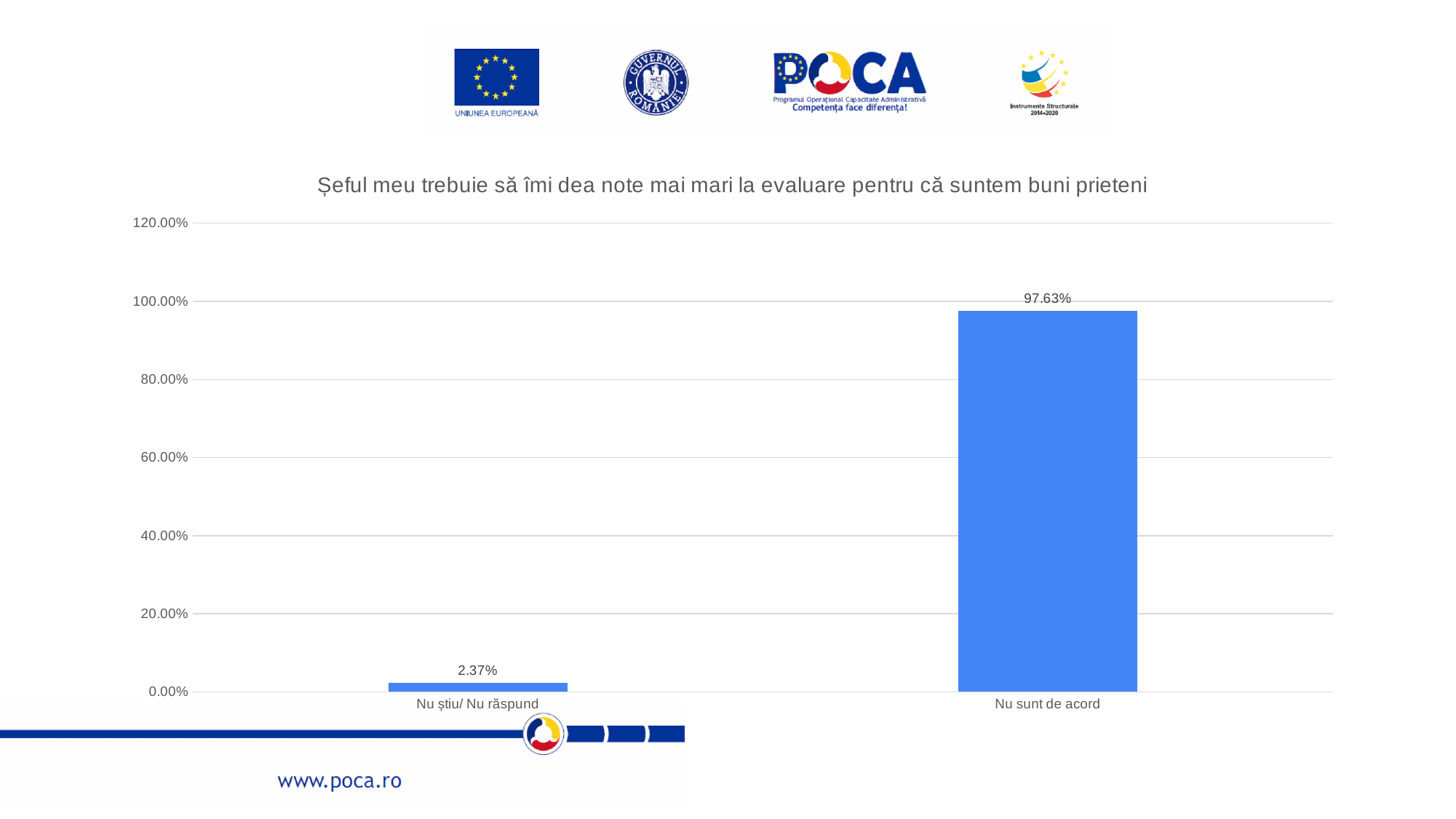
What kind of chart is shown on the slide? bar chart What is the value for "Nu știu/ Nu răspund"? 2.37% What is the title of the chart? Șeful meu trebuie să îmi dea note mai mari la evaluare pentru că suntem buni prieteni Which is larger, the value for "Nu sunt de acord" or the value for "Nu știu/ Nu răspund"? Nu sunt de acord How many categories are shown on the x axis? 2 Which category has the lowest value? Nu știu/ Nu răspund What is the value for "Nu sunt de acord"? 97.63% Is the value for "Nu știu/ Nu răspund" greater or less than 20.00%? less What is the highest value shown on the y axis? 120.00% What is the difference between the values for "Nu sunt de acord" and "Nu știu/ Nu răspund"? 95.26% Which category has the highest value? Nu sunt de acord Is the value for "Nu sunt de acord" greater or less than 80.00%? greater